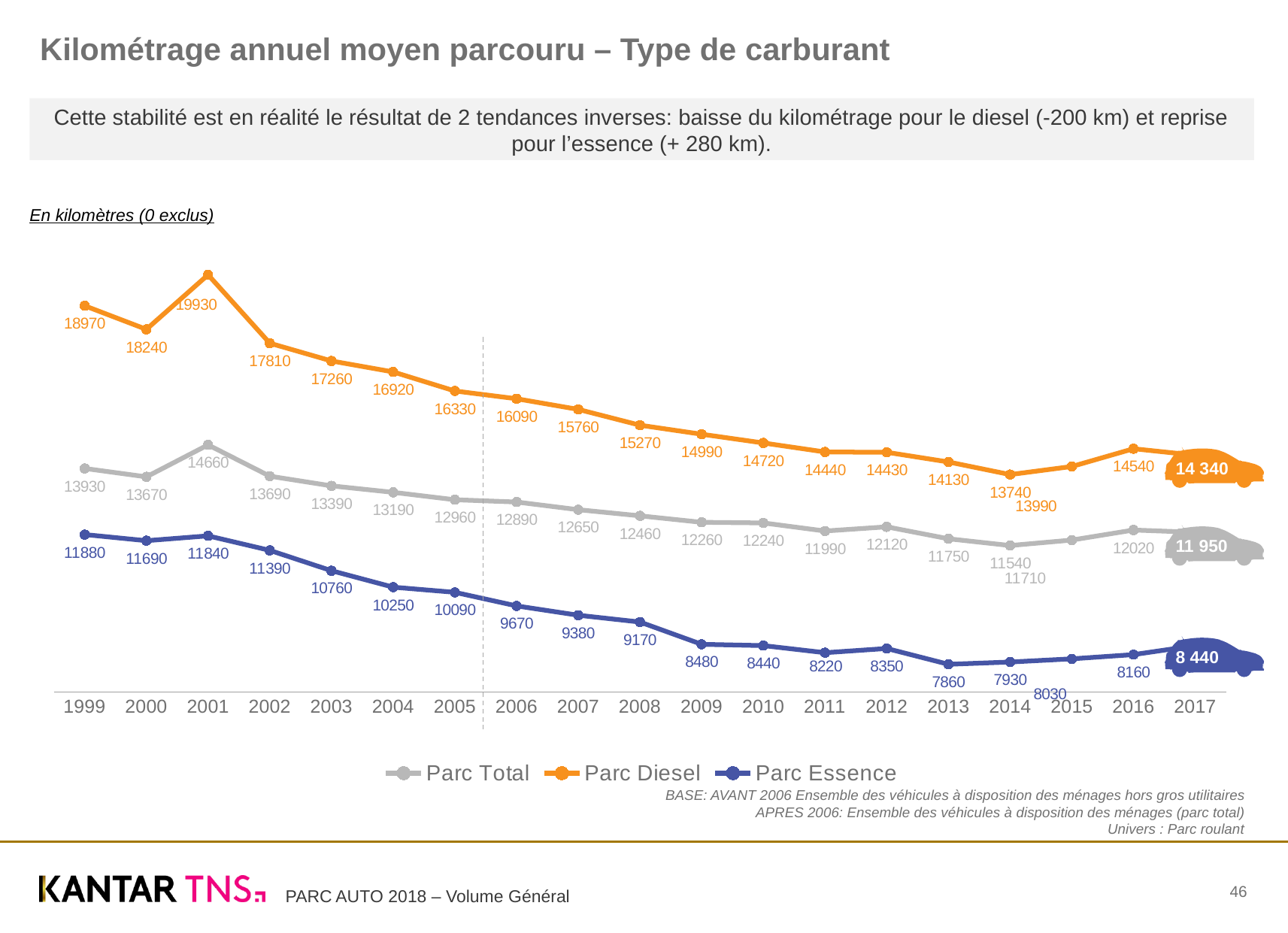
Does the Parc Essence line rise or fall from 1999 to 2013? fall In which year does Parc Diesel reach its highest value? 2001 What are the three series named in the legend? Parc Total, Parc Diesel, Parc Essence In which year is the Parc Essence value lowest? 2013 How many years are shown on the x axis? 19 What kind of chart is shown on the slide? line chart Which is larger for Parc Total: the value in 2001 or the value in 2016? 2001 How many series does the legend list? 3 What is the value for Parc Diesel in 2001? 19930 What is the value for Parc Total in 2010? 12240 What is the difference between the Parc Diesel values in 1999 and 2017? 4630 What is the value for Parc Essence in 2017? 8 440